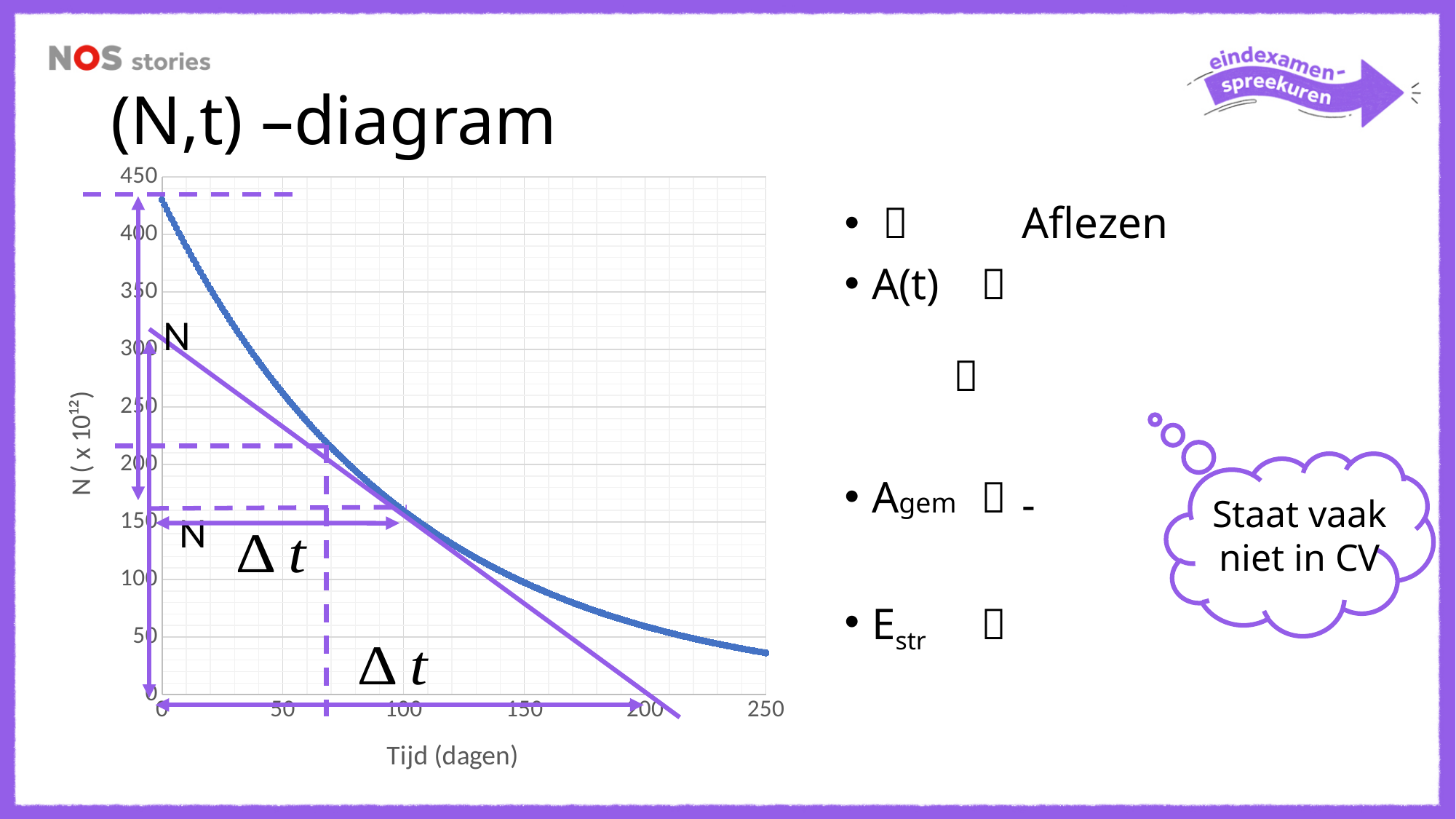
What is the highest tick value shown on the y axis of the chart? 450 Is the value of N at 100 days greater or less than 200? less What kind of chart is shown on the slide? line chart Is the value of N at 250 days greater or less than 50? less Is the value of N at 150 days greater or less than 150? less What is the label of the x axis of the chart? Tijd (dagen) Does the value of N rise or fall as time increases along the x axis? fall